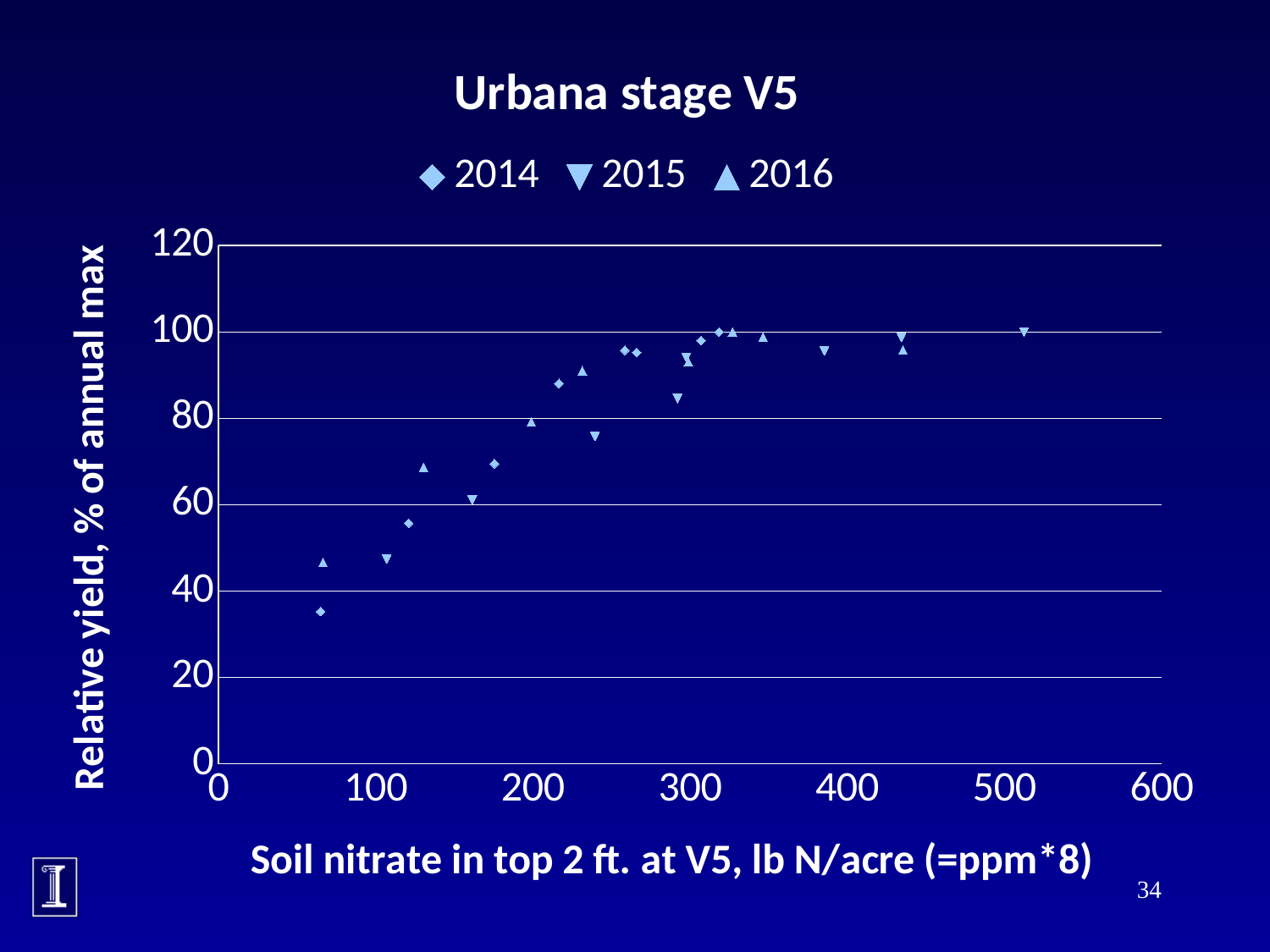
Is the relative yield of the leftmost 2014 point (near 65 lb N/acre) greater or less than 40? less Is the relative yield of the 2015 point near 240 lb N/acre greater or less than 80? less Which series contains the point with the lowest relative yield on the chart? 2014 Is the relative yield of the 2014 point near 175 lb N/acre greater or less than 60? greater Which series contains the point with the highest soil nitrate value (farthest right) on the chart? 2015 What kind of chart is shown on the slide? scatter chart Do the relative yield values generally rise or fall as soil nitrate increases along the x axis? rise What is the label of the y axis? Relative yield, % of annual max What is the title of the chart? Urbana stage V5 Which is higher: the relative yield of the leftmost 2016 point or the leftmost 2014 point? the leftmost 2016 point How many series does the legend list? 3